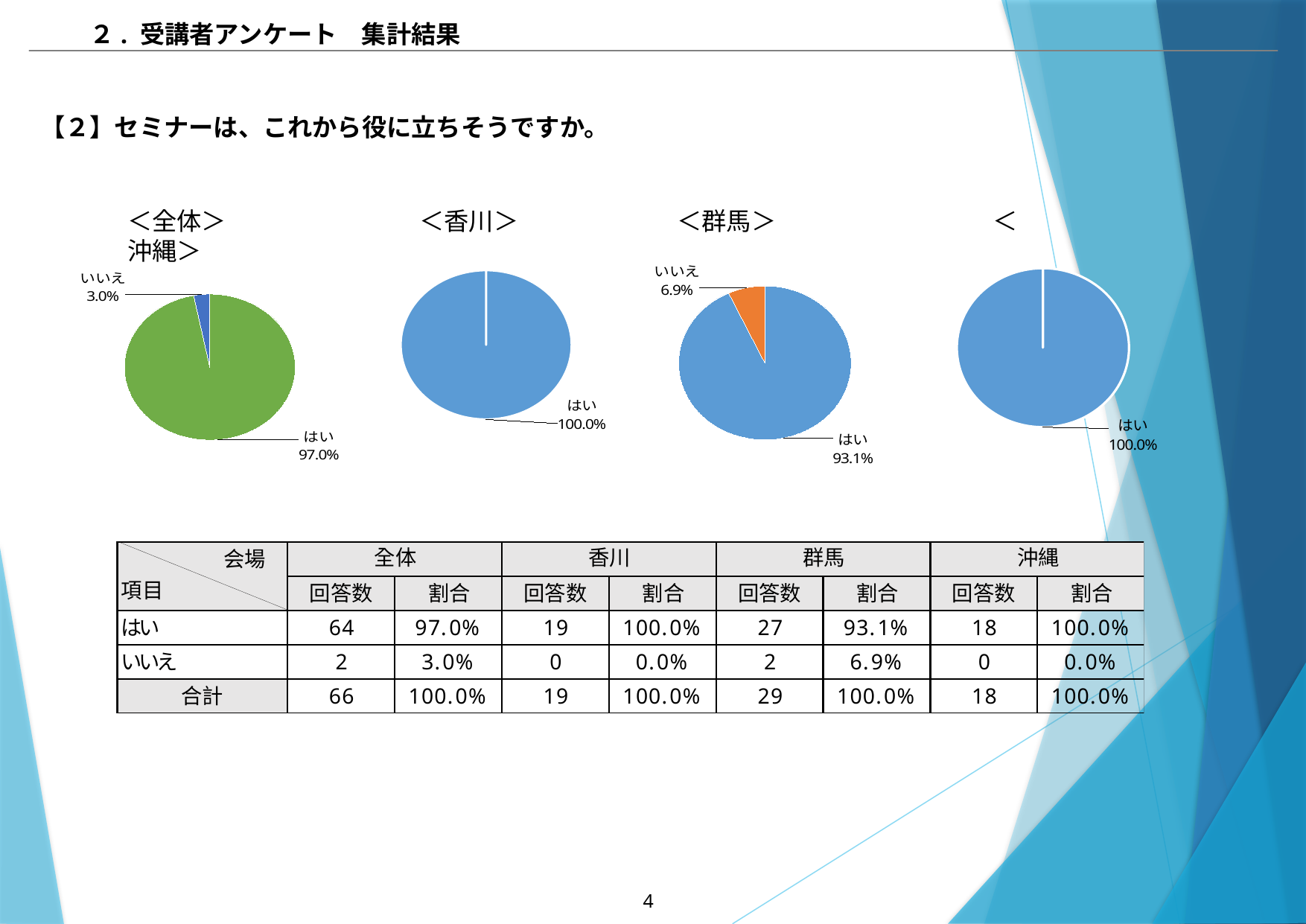
How many labelled slices does the ＜全体＞ pie chart have? 2 What kind of chart is the ＜全体＞ chart? pie chart In the ＜群馬＞ pie chart, what is the difference between the はい share and the いいえ share? 86.2% In the ＜群馬＞ pie chart, which slice is larger, はい or いいえ? はい Which pie chart on the slide has the smallest はい share? ＜群馬＞ In the ＜全体＞ pie chart, what share is labelled for いいえ? 3.0% In the ＜群馬＞ pie chart, what share is labelled for いいえ? 6.9% In the ＜香川＞ pie chart, what share is labelled for はい? 100.0% In the ＜群馬＞ pie chart, what share is labelled for はい? 93.1% In the ＜全体＞ pie chart, what share is labelled for はい? 97.0% How many pie charts are shown on the slide? 4 What colour is the いいえ slice in the ＜群馬＞ pie chart? orange